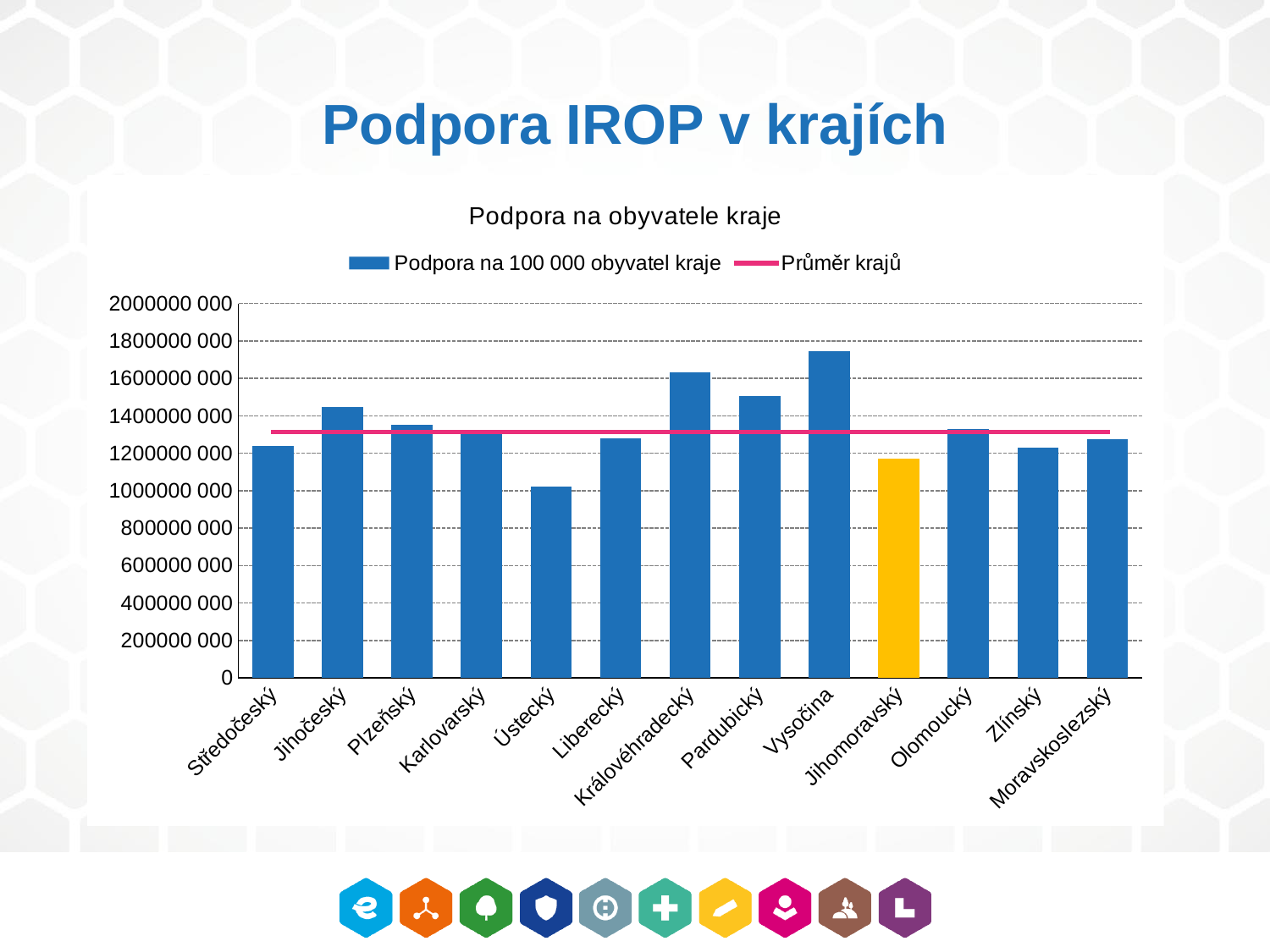
Is the value for Ústecký greater or less than 1200000 000? less What is the name of the line series shown in the legend? Průměr krajů How many series does the chart legend list? 2 How many regions (categories) are shown on the x axis of the chart? 13 Which region has the highest value for Podpora na 100 000 obyvatel kraje? Vysočina Is the value for Královéhradecký greater or less than 1400000 000? greater Which region's bar is coloured yellow instead of blue? Jihomoravský Which has a larger value, Jihočeský or Středočeský? Jihočeský Is the value for Vysočina greater or less than 1600000 000? greater What kind of chart is shown on the slide? combination bar and line chart Which region has the lowest value for Podpora na 100 000 obyvatel kraje? Ústecký